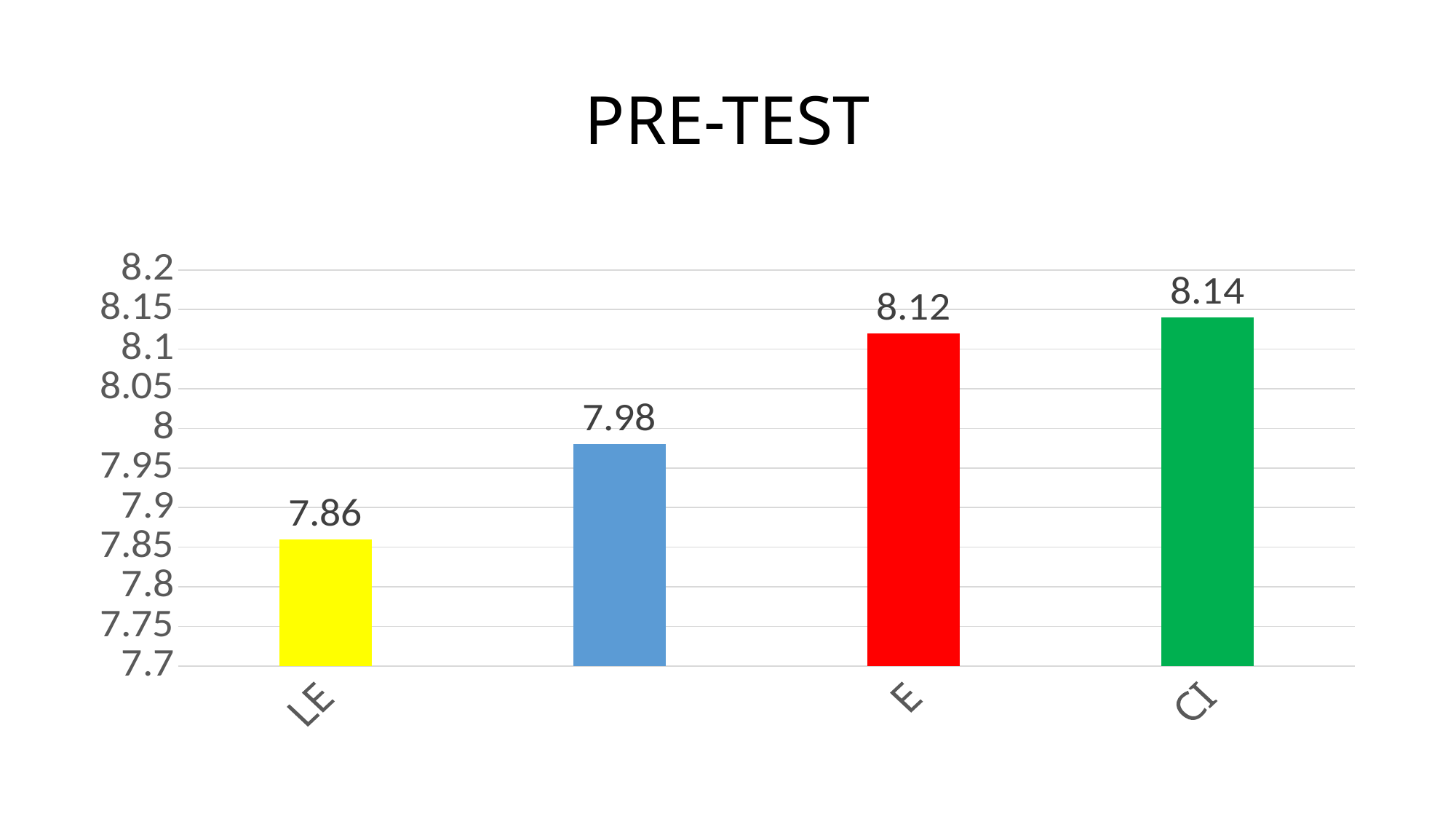
What is the value for LE in the PRE-TEST chart? 7.86 What is the value for CI in the PRE-TEST chart? 8.14 What is the title of the chart? PRE-TEST What is the value for E in the PRE-TEST chart? 8.12 How many bars are shown in the PRE-TEST chart? 4 Is the value for LE greater or less than 7.9? less What is the difference between the values for CI and LE? 0.28 Which category has the lowest value in the PRE-TEST chart? LE What is the difference between the values for E and LE? 0.26 Which is larger, the value for E or the value for LE? E Which category has the highest value in the PRE-TEST chart? CI What kind of chart is shown on the slide? bar chart